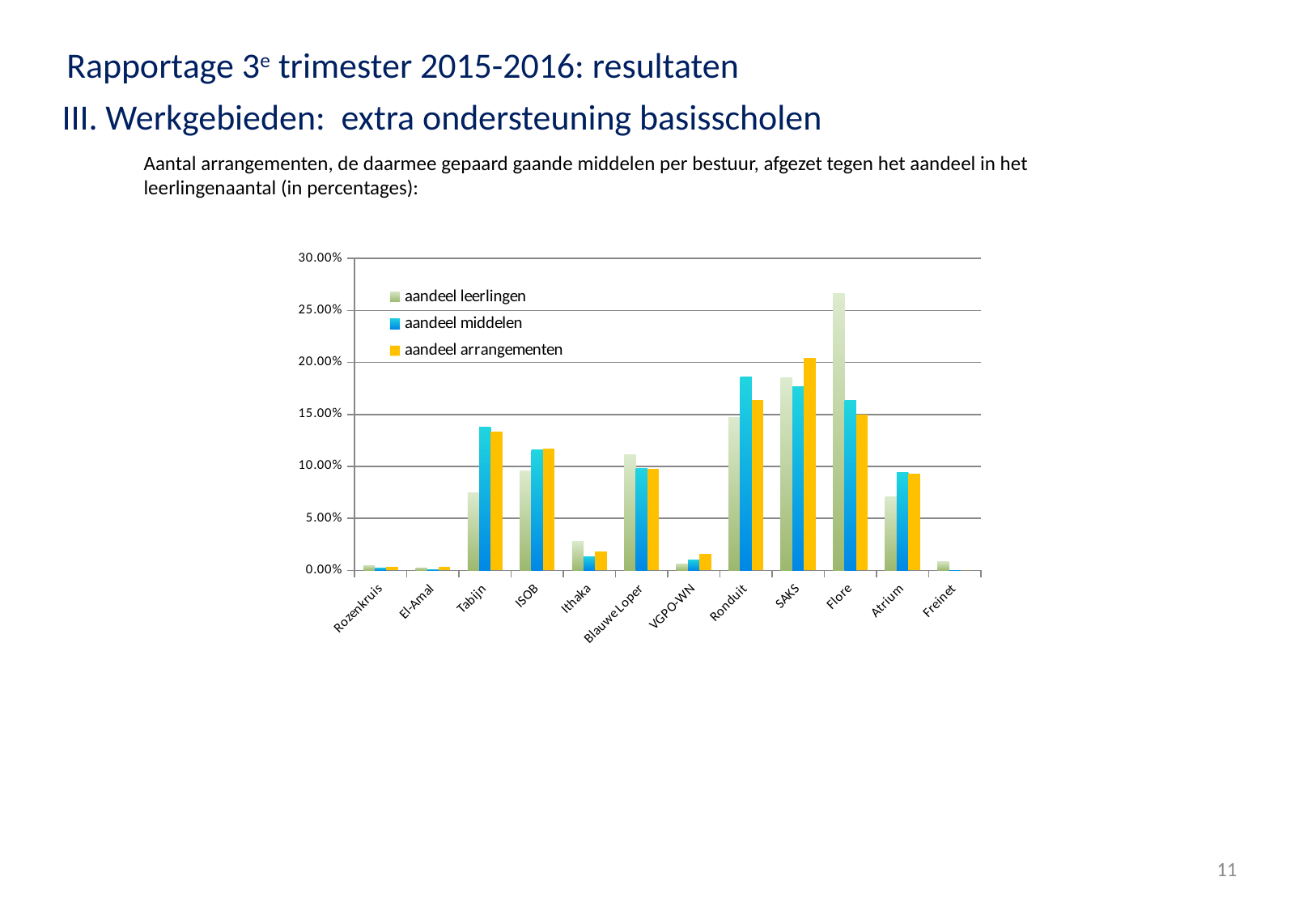
Is the value for aandeel leerlingen at Ithaka greater or less than 5.00%? less What kind of chart is shown on the slide? bar chart How many categories (besturen) are shown on the x axis? 12 For Tabijn, which is larger: aandeel middelen or aandeel leerlingen? aandeel middelen Is the value for aandeel middelen at Tabijn greater or less than 10.00%? greater For Flore, which is larger: aandeel leerlingen or aandeel arrangementen? aandeel leerlingen Which category has the highest value for aandeel leerlingen? Flore Which category has the highest value for aandeel middelen? Ronduit Is the value for aandeel leerlingen at Flore greater or less than 25.00%? greater Which category has the highest value for aandeel arrangementen? SAKS How many series does the legend list? 3